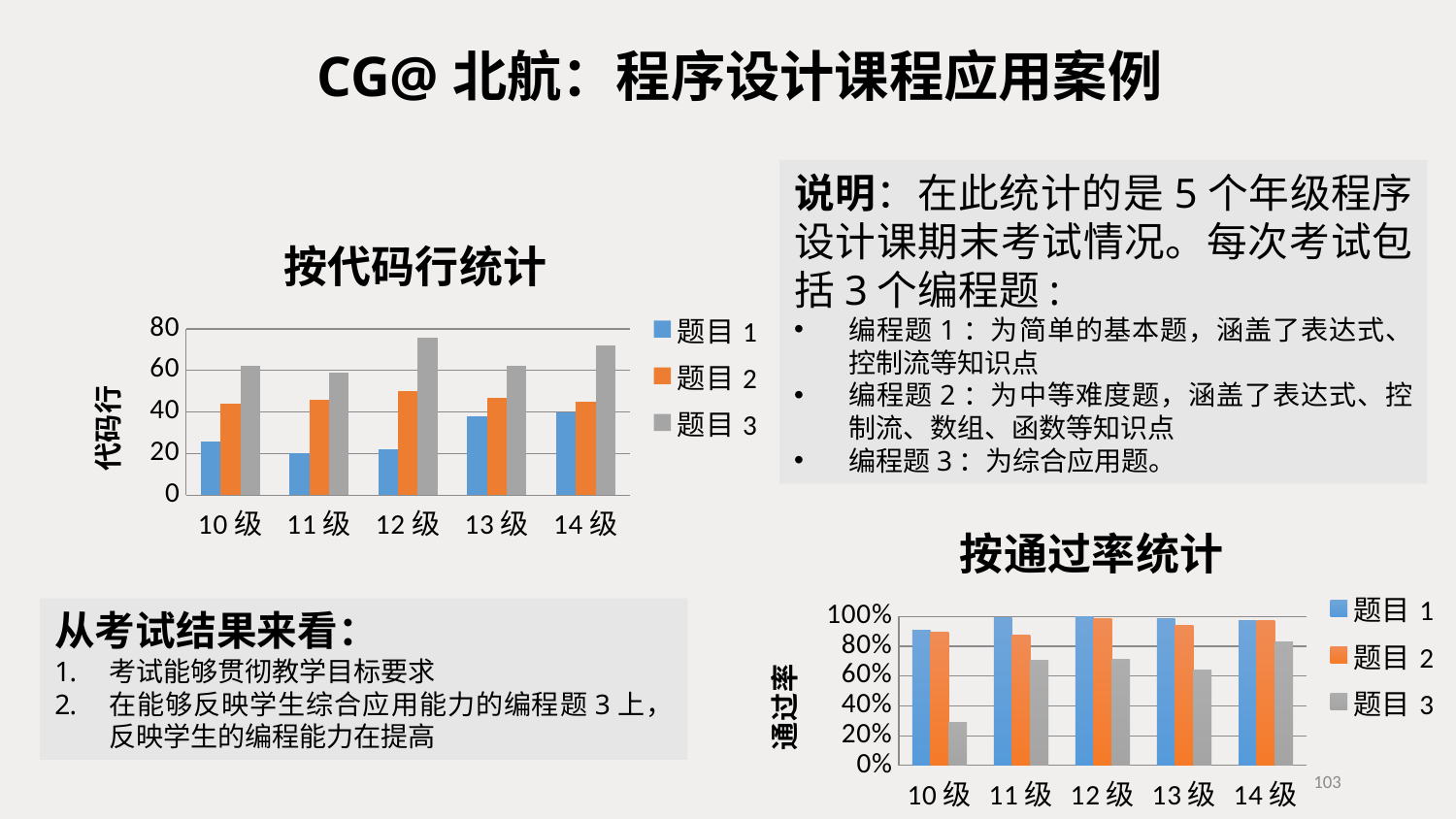
In the "按代码行统计" chart, is the value of 题目 1 for 10 级 greater or less than 40? less How many grade categories are shown on the x axis of the "按代码行统计" chart? 5 How many series does the legend of the "按通过率统计" chart list? 3 In the "按通过率统计" chart, which grade has the lowest pass rate for 题目 3? 10 级 In the "按通过率统计" chart, is the value of 题目 3 for 10 级 greater or less than 40%? less What is the y-axis label of the "按通过率统计" chart? 通过率 In the "按代码行统计" chart, is the value of 题目 3 for 12 级 greater or less than 60? greater In the "按通过率统计" chart, which is larger for 13 级: 题目 1 or 题目 3? 题目 1 In the "按通过率统计" chart, which grade has the highest pass rate for 题目 3? 14 级 What kind of chart is the "按代码行统计" chart? bar chart In the "按代码行统计" chart, which is larger for 10 级: 题目 2 or 题目 3? 题目 3